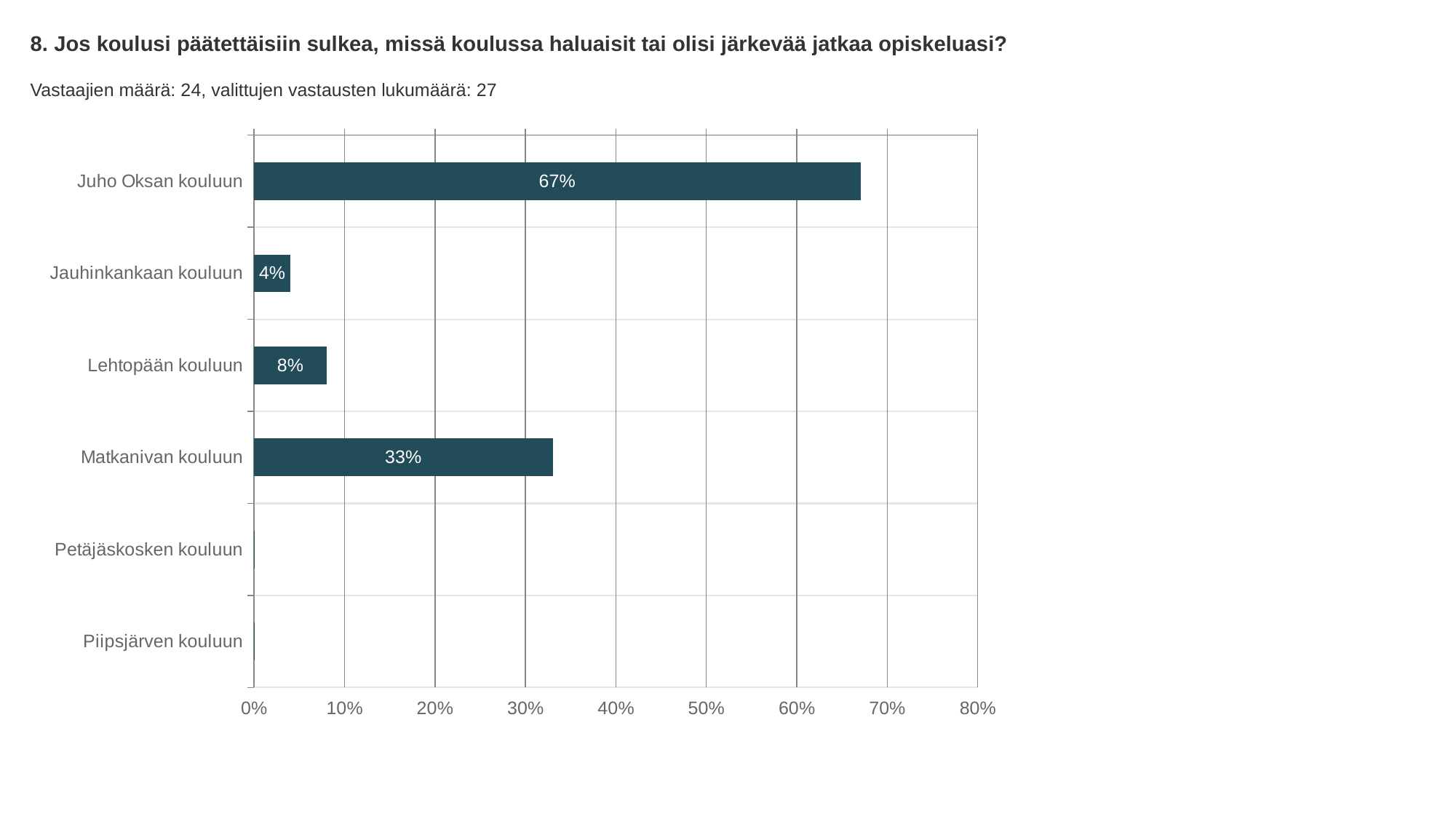
What is the highest value shown on the x axis? 80% What is the value for Lehtopään kouluun? 8% What kind of chart is shown on the slide? bar chart Is the value for Juho Oksan kouluun greater or less than 60%? greater How many categories are shown on the y axis? 6 What is the difference between the values for Juho Oksan kouluun and Matkanivan kouluun? 34% What is the value for Juho Oksan kouluun? 67% Which category has the lowest value among those with a visible bar? Jauhinkankaan kouluun Which is larger, the value for Lehtopään kouluun or Jauhinkankaan kouluun? Lehtopään kouluun What is the value for Jauhinkankaan kouluun? 4% What is the value for Matkanivan kouluun? 33% Which category has the highest value? Juho Oksan kouluun